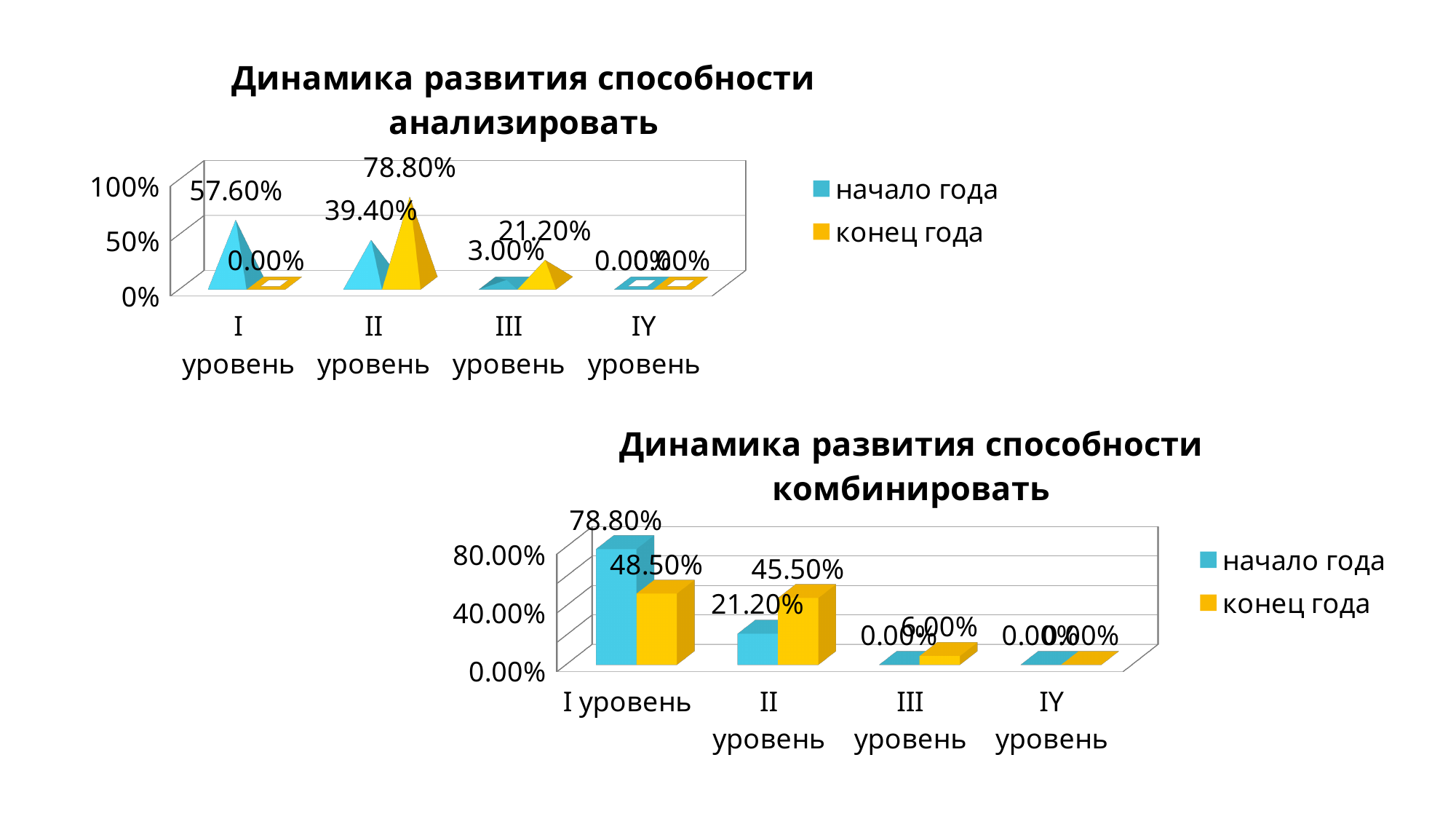
In the chart titled "Динамика развития способности анализировать", which level has the highest "начало года" value? I уровень In the chart titled "Динамика развития способности комбинировать", how many categories are shown on the x axis? 4 In the chart titled "Динамика развития способности комбинировать", what is the value for "конец года" at "II уровень"? 45.50% In the chart titled "Динамика развития способности анализировать", what is the value for "конец года" at "II уровень"? 78.80% In the chart titled "Динамика развития способности комбинировать", what is the value for "конец года" at "III уровень"? 6.00% In the chart titled "Динамика развития способности анализировать", what is the difference between the "конец года" and "начало года" values at "II уровень"? 39.40% In the chart titled "Динамика развития способности комбинировать", what is the value for "начало года" at "I уровень"? 78.80% In the chart titled "Динамика развития способности анализировать", what is the value for "начало года" at "I уровень"? 57.60% In the chart titled "Динамика развития способности анализировать", what is the value for "конец года" at "III уровень"? 21.20% In the chart titled "Динамика развития способности комбинировать", which is larger at "I уровень": "начало года" or "конец года"? начало года What kind of chart is the one titled "Динамика развития способности комбинировать"? Bar chart In the chart titled "Динамика развития способности анализировать", how many series does the legend list? 2